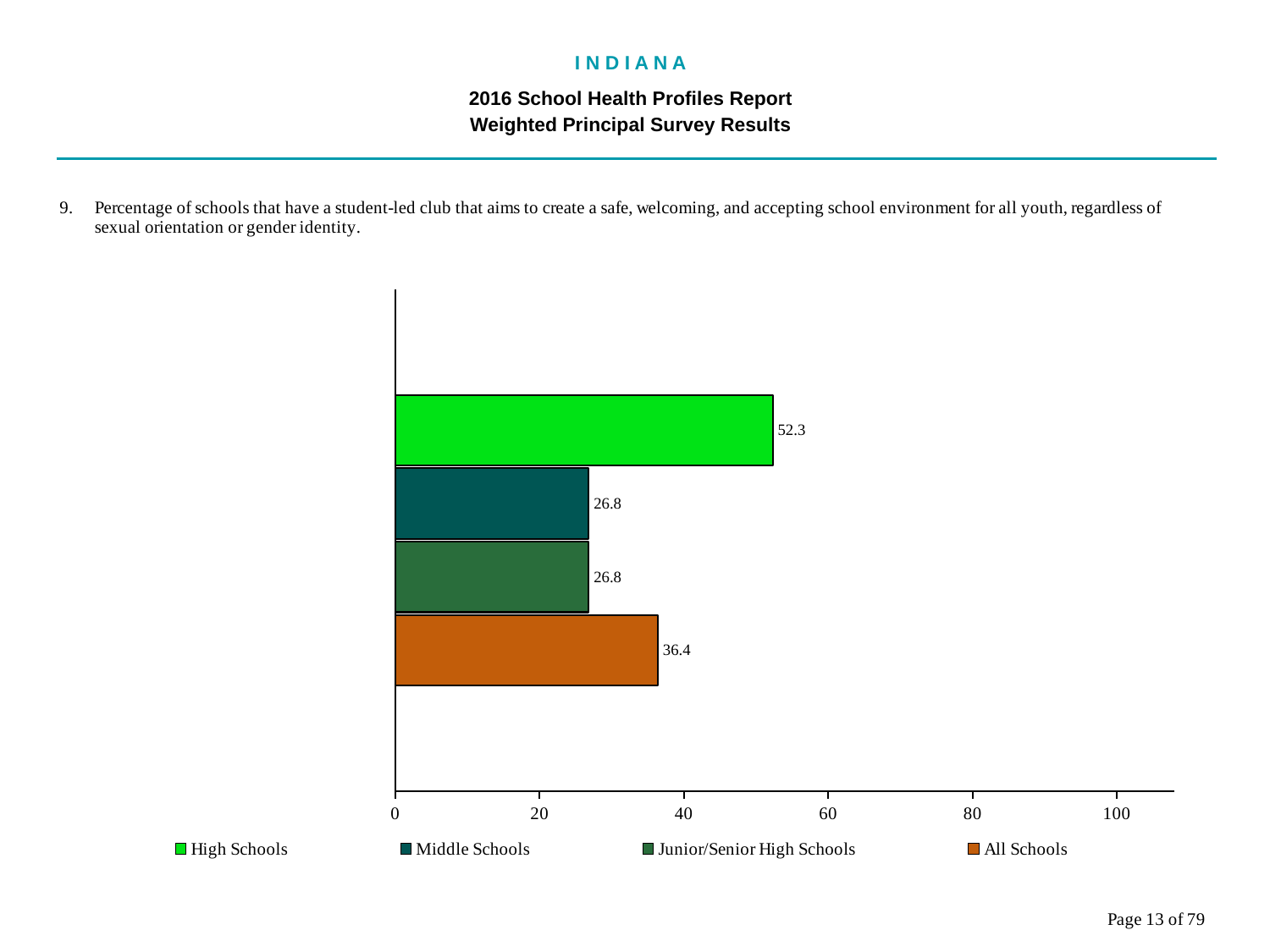
Which is larger, the value for High Schools or the value for All Schools? High Schools What is the value for All Schools? 36.4 What is the value for High Schools? 52.3 Is the value for Junior/Senior High Schools greater or less than 40? less What is the value for Middle Schools? 26.8 What is the difference between the values for High Schools and All Schools? 15.9 How many bars are plotted in the chart? 4 What is the difference between the values for All Schools and Middle Schools? 9.6 Which school type has the highest value? High Schools How many entries does the legend list? 4 Is the value for High Schools greater or less than 40? greater What kind of chart is shown on the slide? bar chart